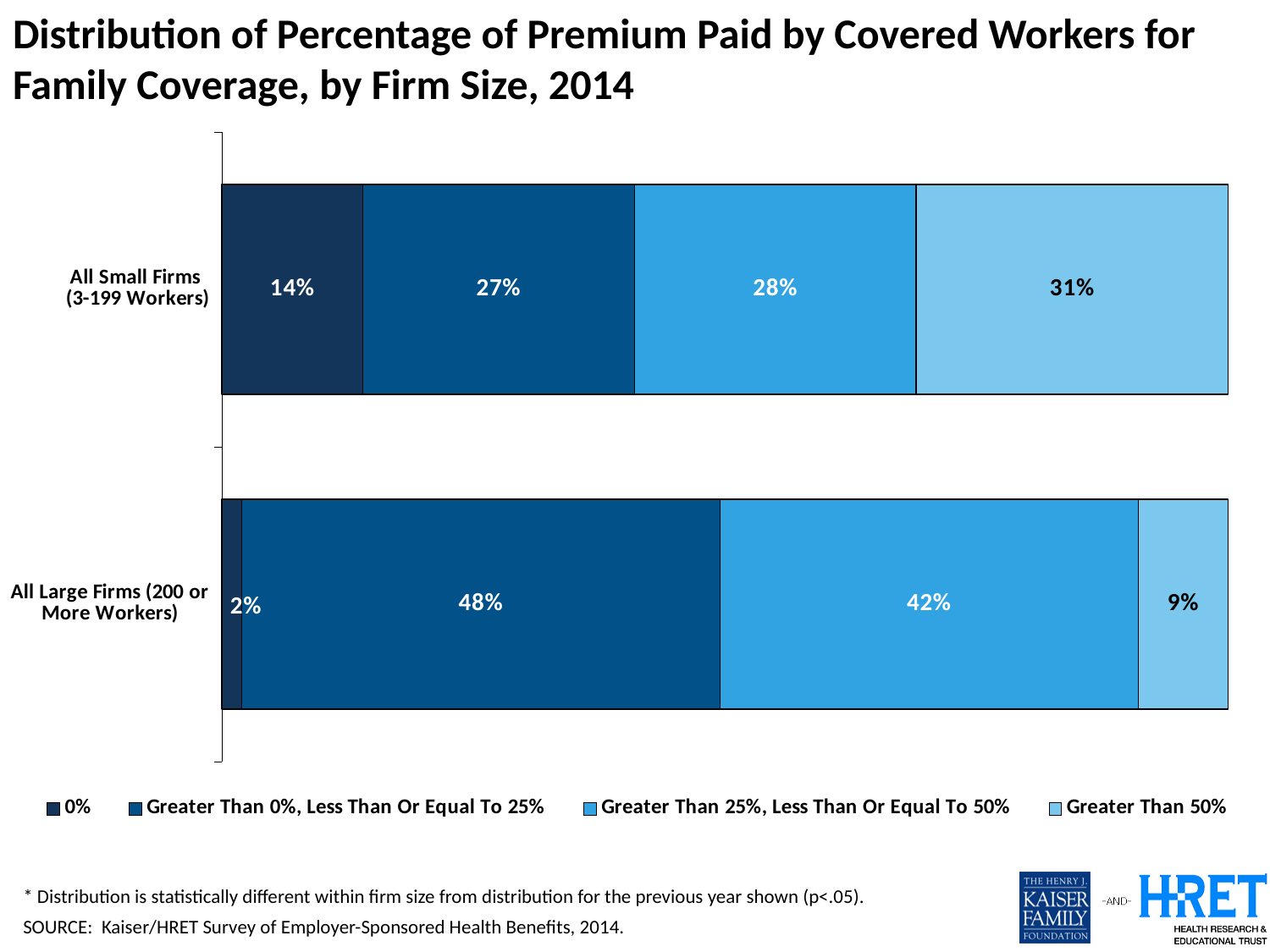
What percentage of covered workers at All Large Firms (200 or More Workers) pay Greater Than 50% of the premium? 9% What type of chart is shown on the slide? Stacked bar chart What is the total of the segments in the All Large Firms (200 or More Workers) bar? 101% What is the value for the 'Greater Than 25%, Less Than Or Equal To 50%' segment for All Small Firms (3-199 Workers)? 28% What is the difference between the 'Greater Than 50%' values for All Small Firms and All Large Firms? 22 percentage points What is the value for the 'Greater Than 0%, Less Than Or Equal To 25%' segment for All Large Firms (200 or More Workers)? 48% Which firm size has a larger share of workers paying 0% of the premium: All Small Firms or All Large Firms? All Small Firms (3-199 Workers) What percentage of covered workers at All Small Firms (3-199 Workers) pay 0% of the premium for family coverage? 14% How many series does the legend list? 4 Which segment is the smallest for All Large Firms (200 or More Workers)? 0% How many firm size categories are shown in the chart? 2 Which segment is the largest for All Small Firms (3-199 Workers)? Greater Than 50%